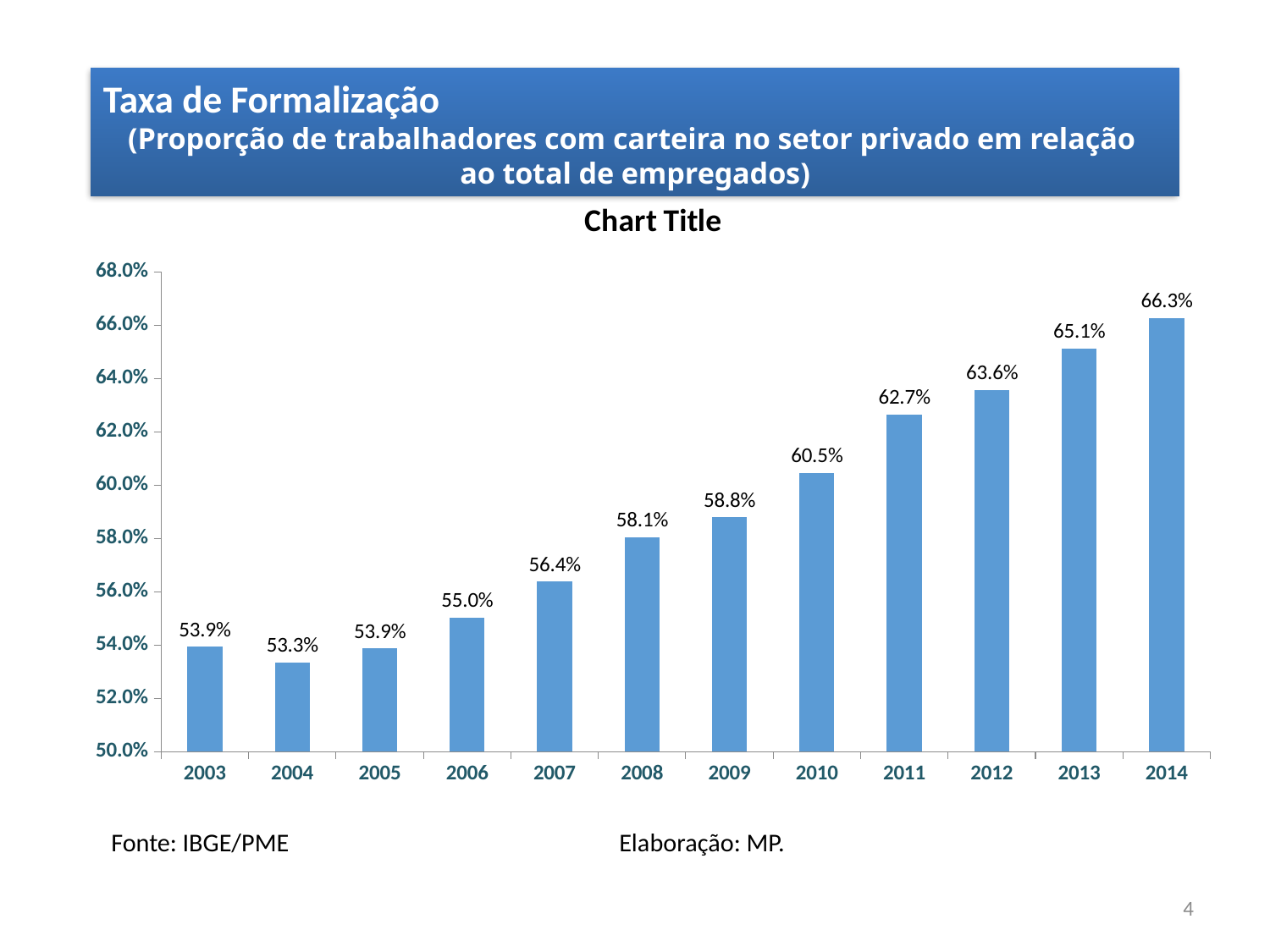
What is the difference between the values for 2014 and 2003? 12.4% What source is cited below the chart? IBGE/PME Which year has the highest value? 2014 What kind of chart is shown on the slide? bar chart How many years are shown on the x axis? 12 Which year has the lowest value? 2004 Which is larger, the value for 2008 or the value for 2009? 2009 What is the value for 2010? 60.5% What is the difference between the values for 2012 and 2011? 0.9% Do the values generally rise or fall from 2004 to 2014? rise Is the value for 2013 greater or less than 64.0%? greater What is the value for 2006? 55.0%